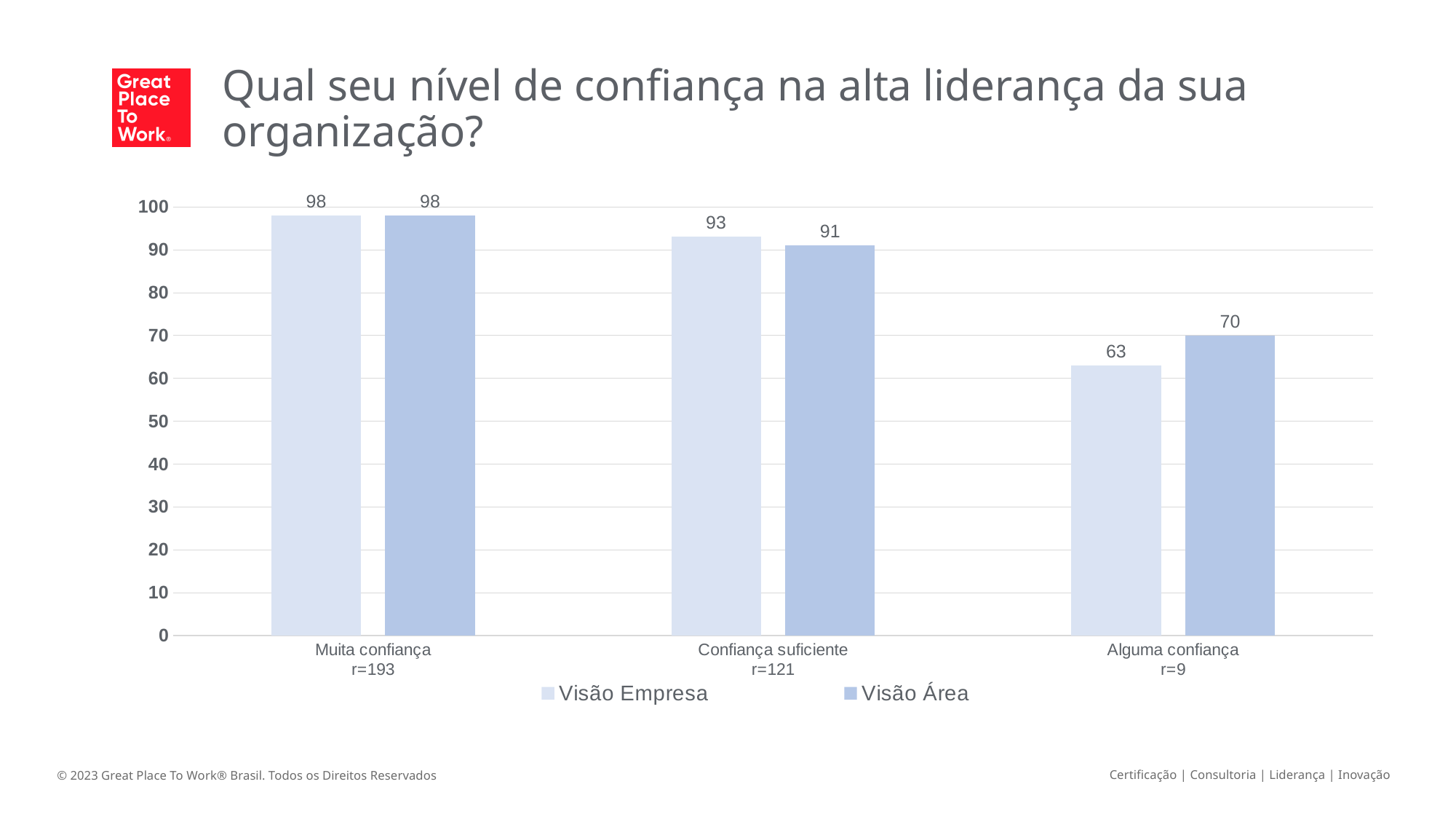
What kind of chart is shown on the slide? Bar chart For Confiança suficiente, which is larger: Visão Empresa or Visão Área? Visão Empresa What is the Visão Área value for Alguma confiança? 70 What is the Visão Empresa value for Muita confiança? 98 What is the Visão Área value for Confiança suficiente? 91 What is the Visão Empresa value for Alguma confiança? 63 What is the number of respondents (r) shown for Confiança suficiente? r=121 Which category has the lowest Visão Empresa value? Alguma confiança How many categories are shown on the x axis? 3 How many series does the legend list? 2 What is the difference between the Visão Área and Visão Empresa values for Alguma confiança? 7 Which category has the highest Visão Área value? Muita confiança